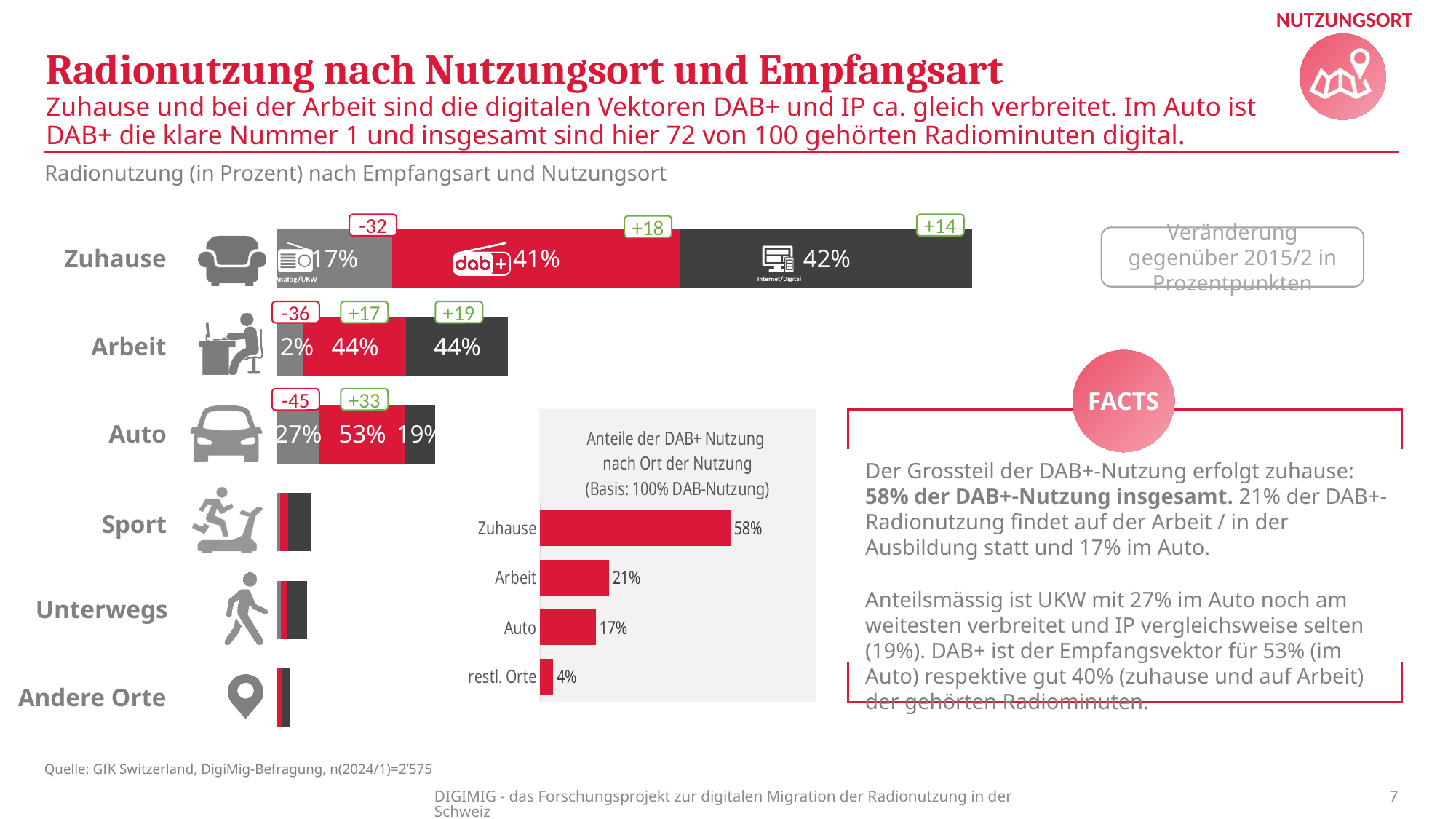
In the stacked bar chart on the left, what is the Analog/UKW share for Auto? 27% How many categories are shown in the chart 'Anteile der DAB+ Nutzung nach Ort der Nutzung'? 4 In the stacked bar chart on the left, what is the Internet/Digital share for Arbeit? 44% In the stacked bar chart on the left, what is the total of the three labelled segments of the Zuhause bar? 100% What type of chart is 'Anteile der DAB+ Nutzung nach Ort der Nutzung'? Bar chart In the stacked bar chart on the left, what percentage of radio use at Zuhause is via DAB+? 41% In the chart 'Anteile der DAB+ Nutzung nach Ort der Nutzung', what is the value for Auto? 17% In the chart 'Anteile der DAB+ Nutzung nach Ort der Nutzung', which location has the lowest share? restl. Orte In the stacked bar chart on the left, what is the change versus 2015/2 shown for DAB+ in the Auto bar? +33 In the chart 'Anteile der DAB+ Nutzung nach Ort der Nutzung', how many percentage points higher is Zuhause than Arbeit? 37 percentage points In the chart 'Anteile der DAB+ Nutzung nach Ort der Nutzung', which location has the highest share? Zuhause In the stacked bar chart on the left, which is larger for Auto: the DAB+ share or the Internet/Digital share? DAB+